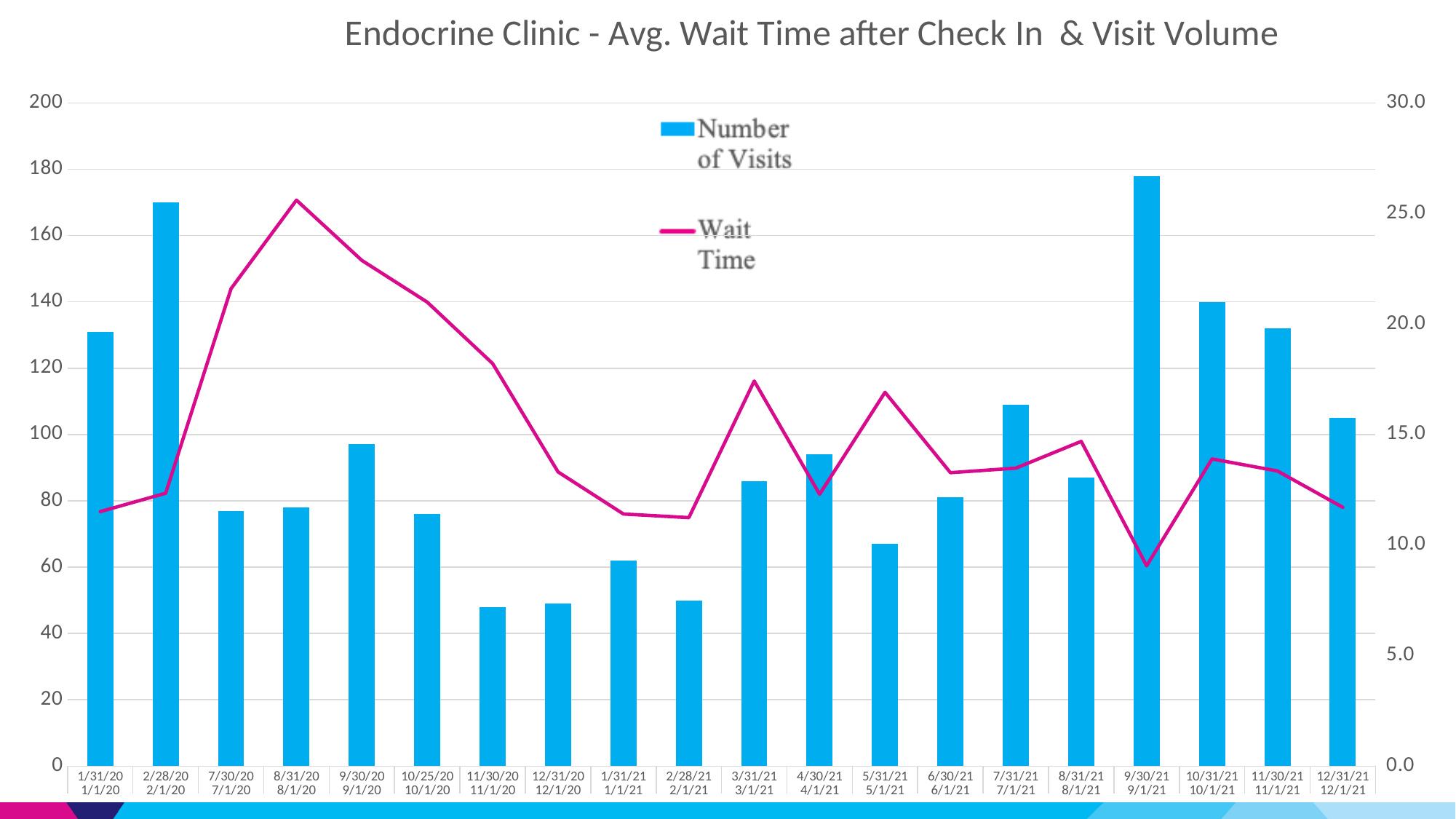
Is the Wait Time for 9/30/21 greater or less than 10.0? less Is the Number of Visits for 9/30/20 greater or less than 100? less Which date has a higher Number of Visits, 1/31/20 or 2/28/20? 2/28/20 On which date does the Wait Time line reach its highest point? 8/31/20 Which date has the highest Number of Visits? 9/30/21 Is the Number of Visits for 2/28/20 greater or less than 160? greater On which date does the Wait Time line reach its lowest point? 9/30/21 How many series does the legend list? 2 How many dates are shown along the x axis? 20 What kind of chart is this? Combined bar and line chart What is the title of the chart? Endocrine Clinic - Avg. Wait Time after Check In & Visit Volume Which series is drawn as a line in the chart? Wait Time